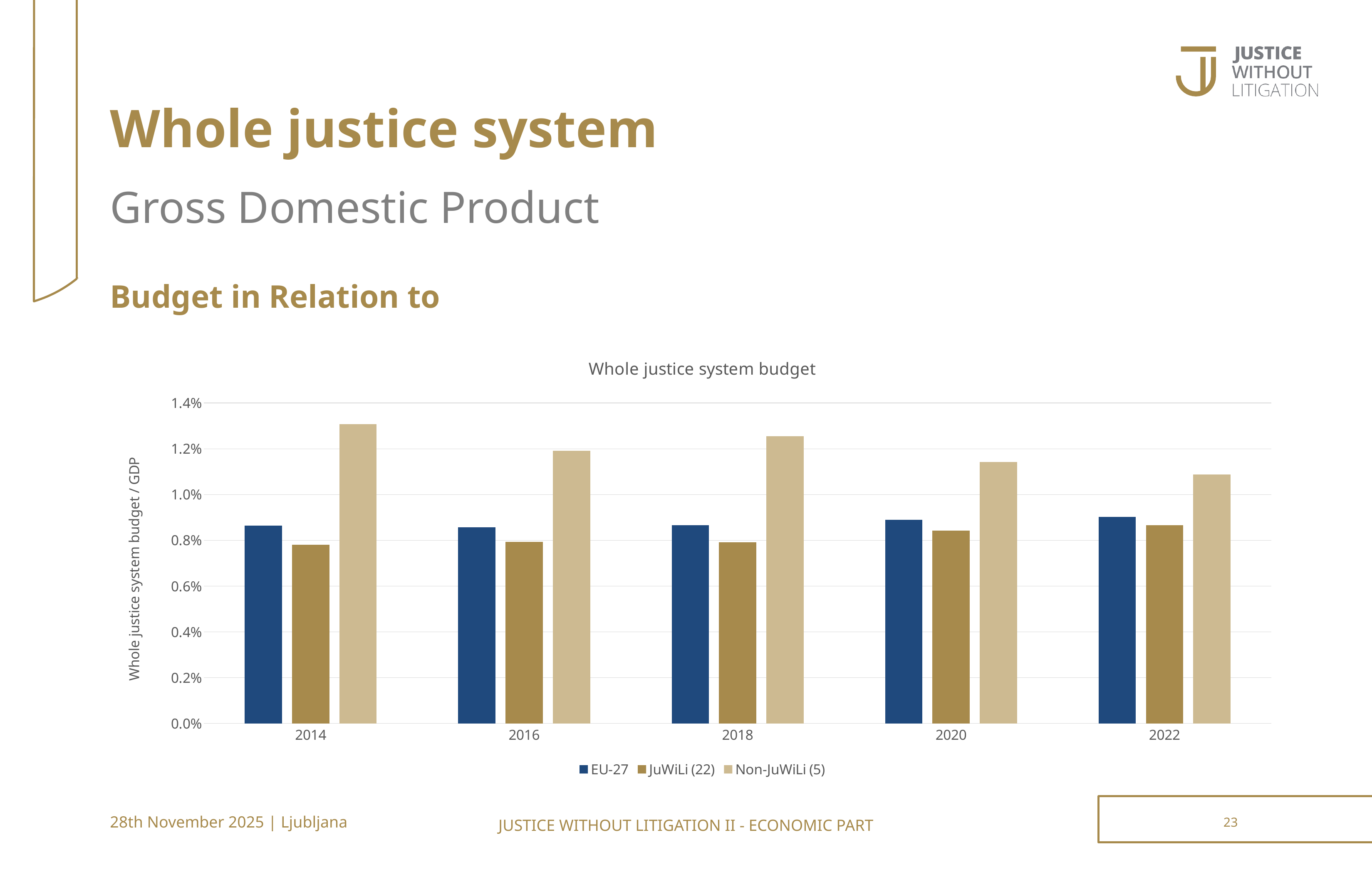
How many years are shown on the x axis? 5 Is the EU-27 value for 2022 greater or less than 1.0%? less Which series has the highest value in every year shown? Non-JuWiLi (5) What is the title of the chart? Whole justice system budget Is the JuWiLi (22) value for 2014 greater or less than 1.0%? less What kind of chart is shown on the slide? bar chart In 2018, which is larger: the Non-JuWiLi (5) value or the JuWiLi (22) value? Non-JuWiLi (5) In 2014, which is larger: the EU-27 value or the JuWiLi (22) value? EU-27 Is the Non-JuWiLi (5) value for 2014 greater or less than 1.2%? greater In which year is the Non-JuWiLi (5) value highest? 2014 How many series does the legend list? 3 In which year is the Non-JuWiLi (5) value lowest? 2022